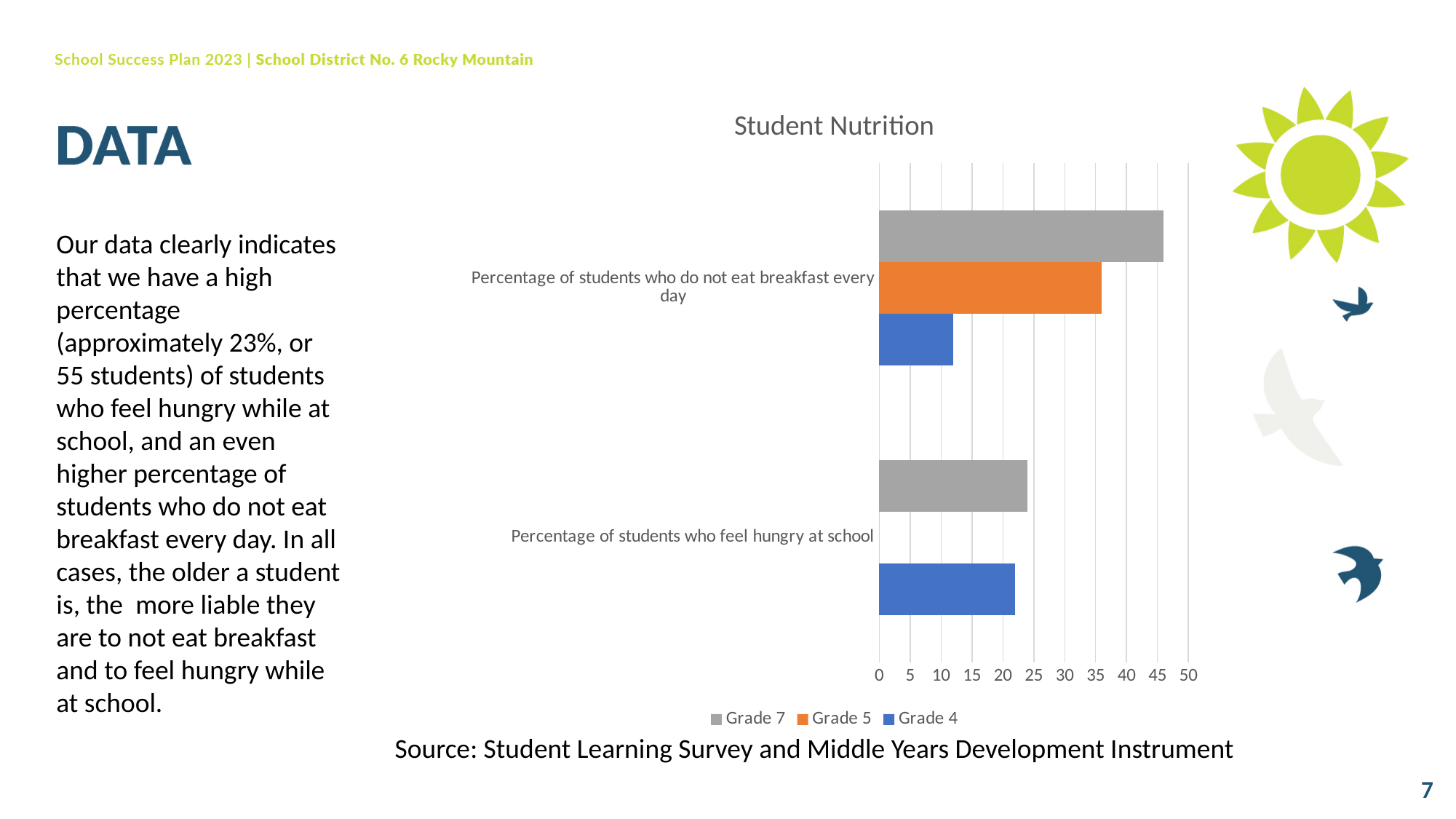
How many categories are shown on the chart's vertical axis? 2 Is the Grade 5 value for percentage of students who do not eat breakfast every day greater or less than 30? greater Is the Grade 4 value for percentage of students who feel hungry at school greater or less than 25? less Is the Grade 4 value for percentage of students who do not eat breakfast every day greater or less than 15? less What type of chart is shown on the slide? bar chart How many series does the chart legend list? 3 Which grade has the highest percentage of students who do not eat breakfast every day? Grade 7 For percentage of students who do not eat breakfast every day, which is larger: Grade 7 or Grade 4? Grade 7 Which grade has the lowest percentage of students who do not eat breakfast every day? Grade 4 Which legend entry is shown in orange? Grade 5 What is the title of the chart? Student Nutrition